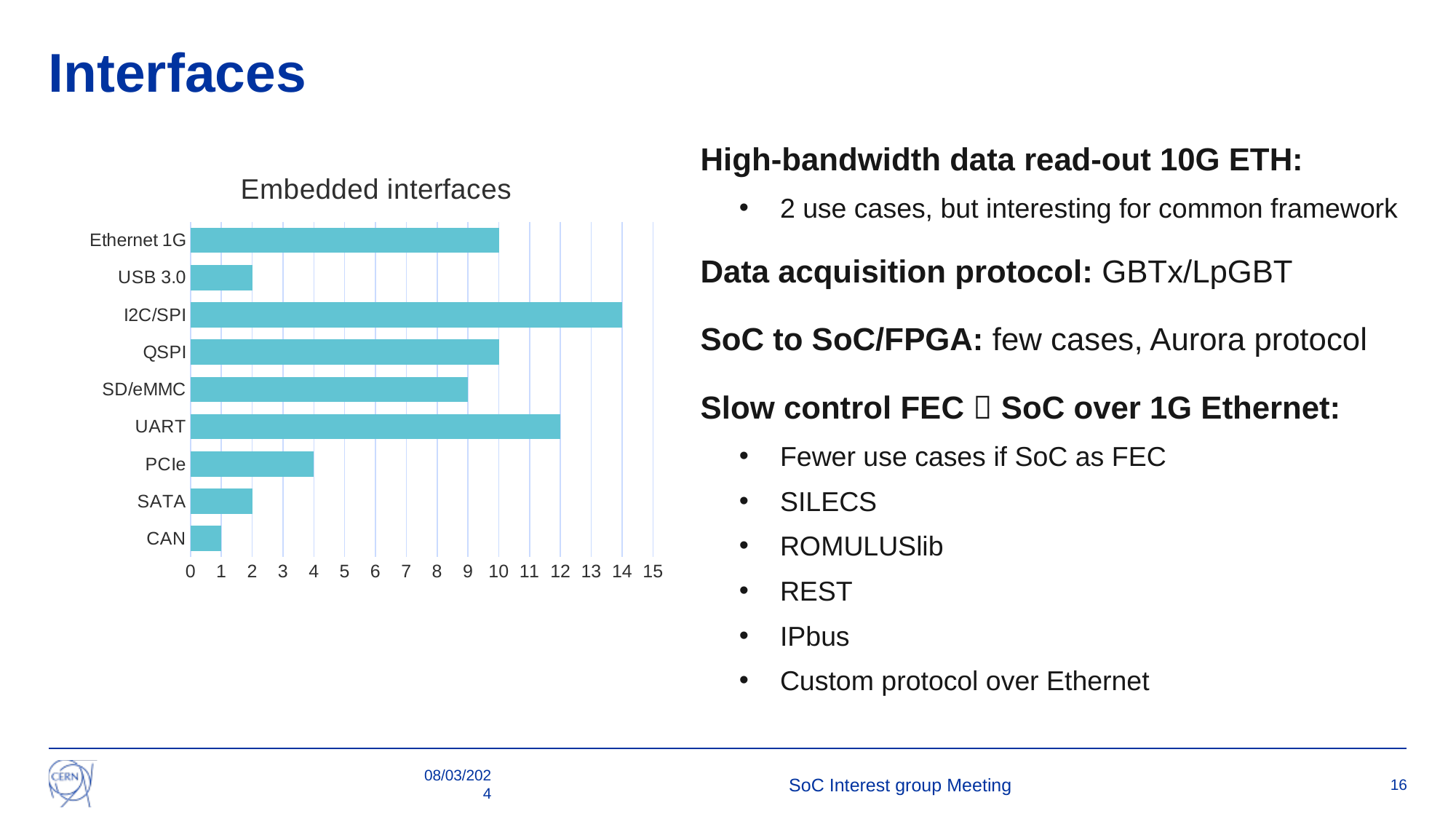
Which is larger, the value for Ethernet 1G or the value for SD/eMMC? Ethernet 1G What is the value for SD/eMMC? 9 What is the value for UART? 12 What is the difference between the values for I2C/SPI and UART? 2 Is the value for QSPI greater or less than 5? greater Which interface has the lowest value in the chart? CAN What is the value for I2C/SPI? 14 What kind of chart is shown on the slide? bar chart What is the value for PCIe? 4 How many interface categories are plotted in the chart? 9 What is the title of the chart? Embedded interfaces Which interface has the highest value in the chart? I2C/SPI